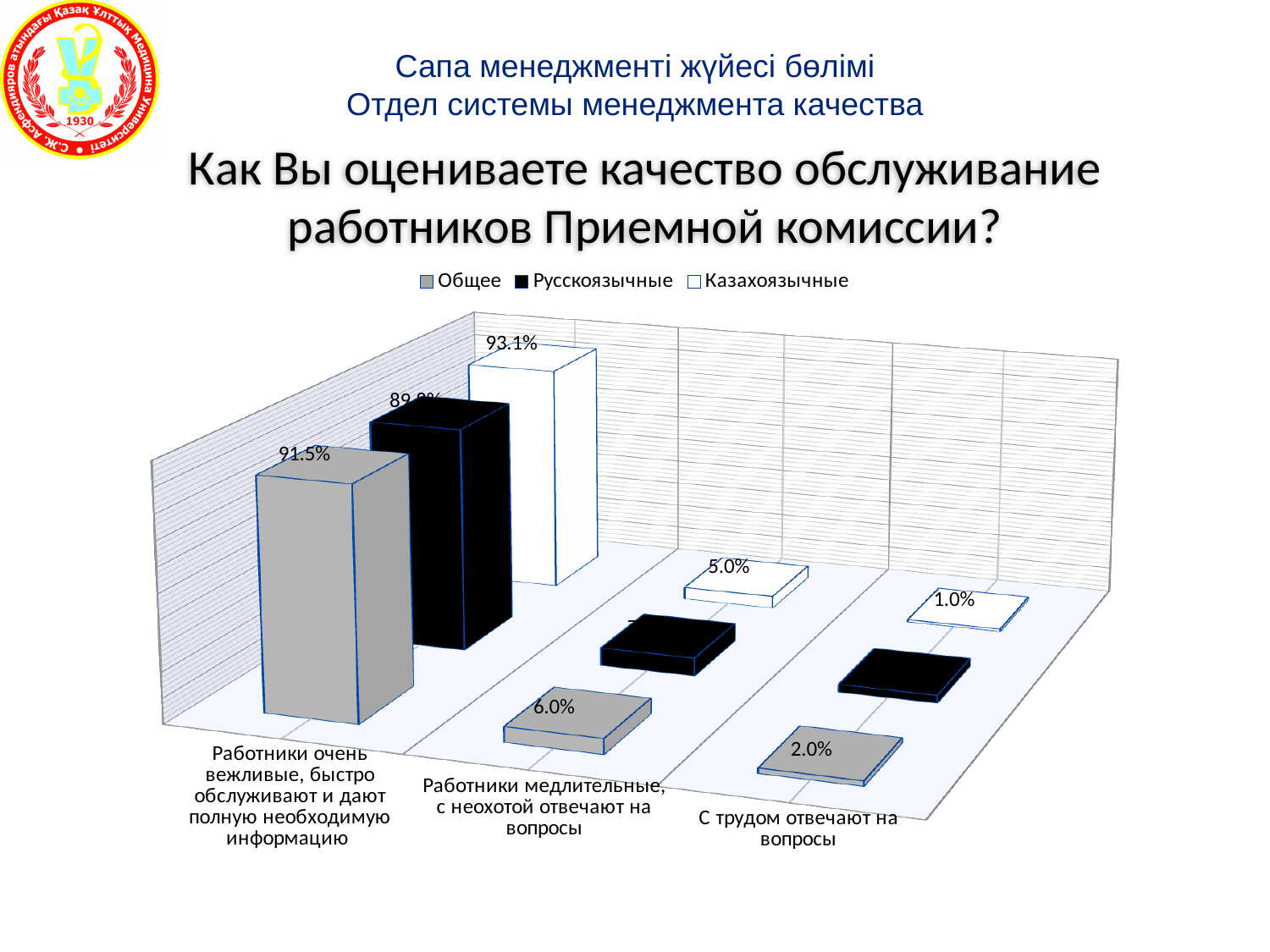
What is the value for Казахоязычные in the category "С трудом отвечают на вопросы"? 1.0% In the category "Работники очень вежливые, быстро обслуживают и дают полную необходимую информацию", which is larger: Общее or Казахоязычные? Казахоязычные What is the value for Казахоязычные in the category "Работники медлительные, с неохотой отвечают на вопросы"? 5.0% Which category has the lowest value for the Казахоязычные series? С трудом отвечают на вопросы What is the value for Общее in the category "Работники очень вежливые, быстро обслуживают и дают полную необходимую информацию"? 91.5% How many series does the legend list? 3 What is the difference between the Казахоязычные values for "Работники очень вежливые, быстро обслуживают и дают полную необходимую информацию" and "Работники медлительные, с неохотой отвечают на вопросы"? 88.1% What is the value for Общее in the category "Работники медлительные, с неохотой отвечают на вопросы"? 6.0% Do the Общее values rise or fall from the first category to the last? fall Which category has the highest value for the Общее series? Работники очень вежливые, быстро обслуживают и дают полную необходимую информацию What is the value for Общее in the category "С трудом отвечают на вопросы"? 2.0% What is the value for Казахоязычные in the category "Работники очень вежливые, быстро обслуживают и дают полную необходимую информацию"? 93.1%